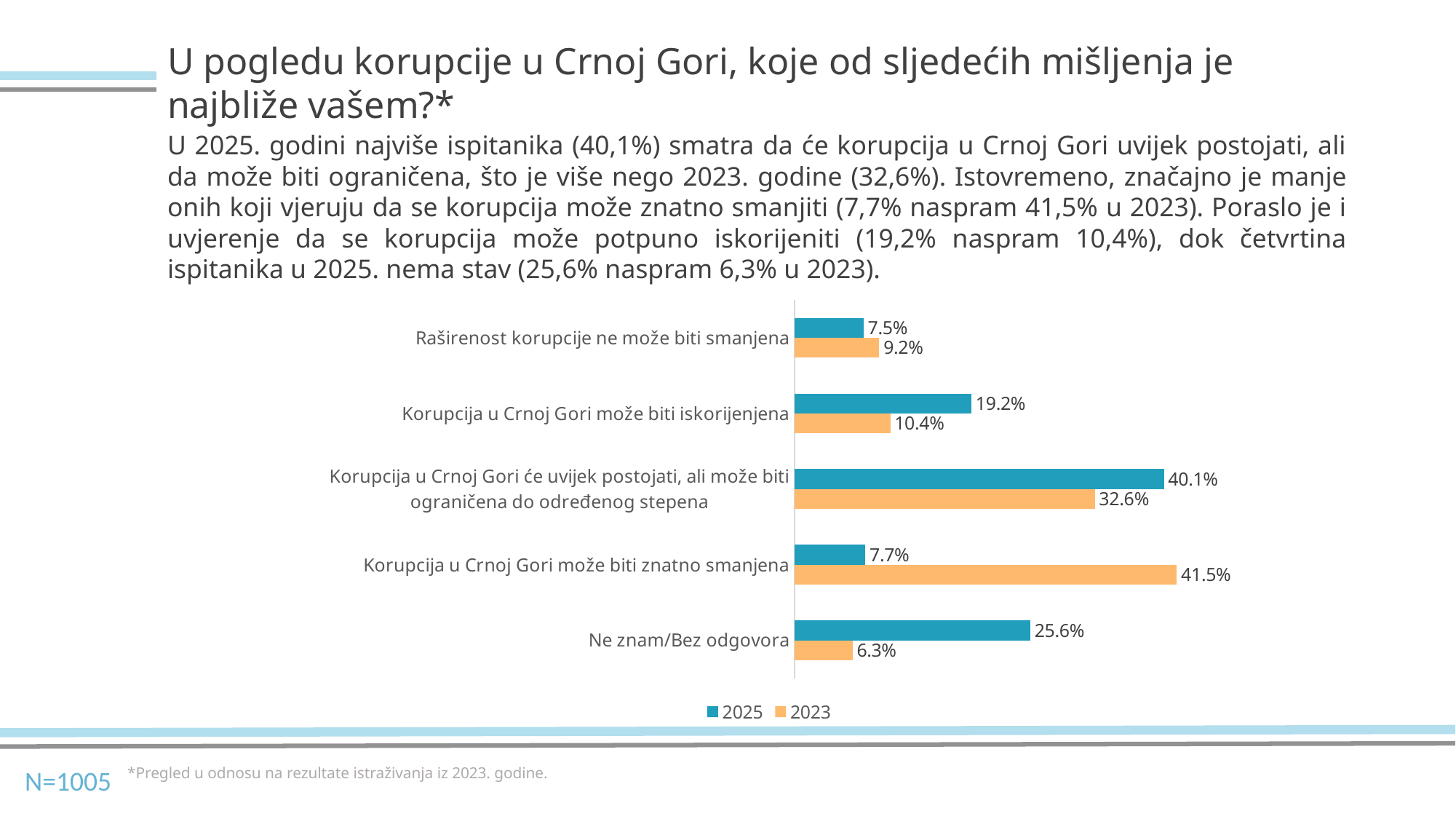
Which colour represents the 2023 series in the chart? Orange How many series does the legend list? 2 What is the 2023 value for "Korupcija u Crnoj Gori može biti znatno smanjena"? 41.5% What is the 2025 value for "Korupcija u Crnoj Gori može biti iskorijenjena"? 19.2% What is the 2023 value for "Ne znam/Bez odgovora"? 6.3% What is the difference between the 2023 and 2025 values for "Korupcija u Crnoj Gori može biti znatno smanjena"? 33.8 percentage points For "Raširenost korupcije ne može biti smanjena", which year has the larger value, 2025 or 2023? 2023 Which category has the highest 2025 value? Korupcija u Crnoj Gori će uvijek postojati, ali može biti ograničena do određenog stepena Which category has the lowest 2023 value? Ne znam/Bez odgovora What is the difference between the 2025 and 2023 values for "Ne znam/Bez odgovora"? 19.3 percentage points How many categories are shown in the chart? 5 What type of chart is shown on the slide? Bar chart